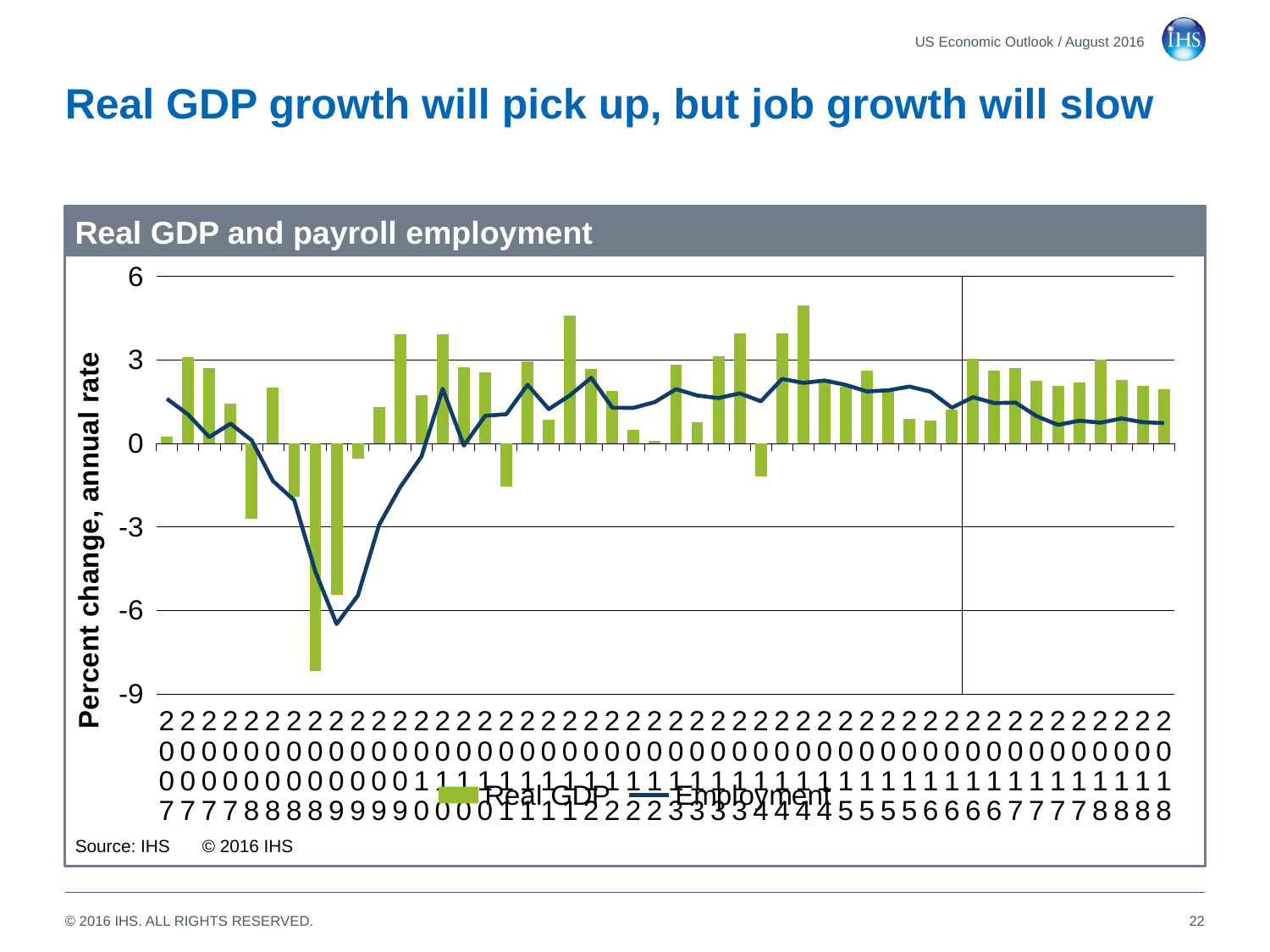
Is the lowest Real GDP bar greater or less than -6? less What kind of chart is shown on the slide? A combined bar and line chart What is the title of the chart? Real GDP and payroll employment Which series reaches the lower minimum value, Real GDP or Employment? Real GDP Is the highest Real GDP bar greater or less than 6? less Is the highest Real GDP bar greater or less than 3? greater How many series does the chart legend list? 2 What are the two series named in the legend? Real GDP and Employment Which series reaches the higher maximum value, Real GDP or Employment? Real GDP Does the Employment line rise or fall across the forecast period to the right of the vertical divider line? fall